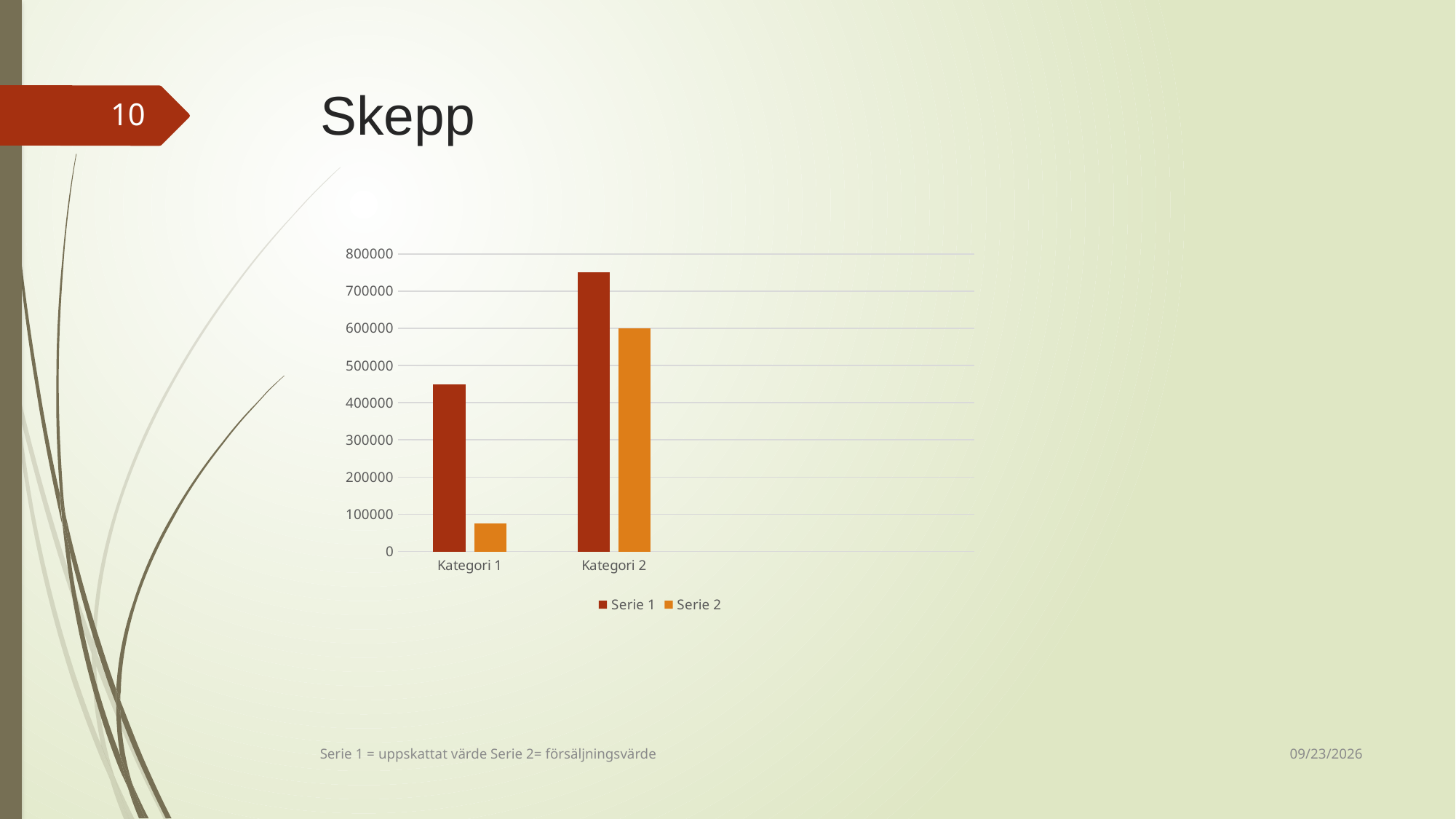
Is the value of Serie 1 for Kategori 1 greater or less than 400000? greater Which bar in the chart is the highest? Serie 1 for Kategori 2 Which bar in the chart is the lowest? Serie 2 for Kategori 1 Which series is shown in the dark red bars? Serie 1 What kind of chart is shown on the slide? bar chart Is the value of Serie 1 for Kategori 2 greater or less than 700000? greater What is the value of Serie 2 for Kategori 2? 600000 How many series does the chart's legend list? 2 Does the value of Serie 1 rise or fall from Kategori 1 to Kategori 2? rise How many categories are shown on the x axis of the chart? 2 Is the value of Serie 2 for Kategori 1 greater or less than 100000? less For Kategori 1, which series has the larger value, Serie 1 or Serie 2? Serie 1